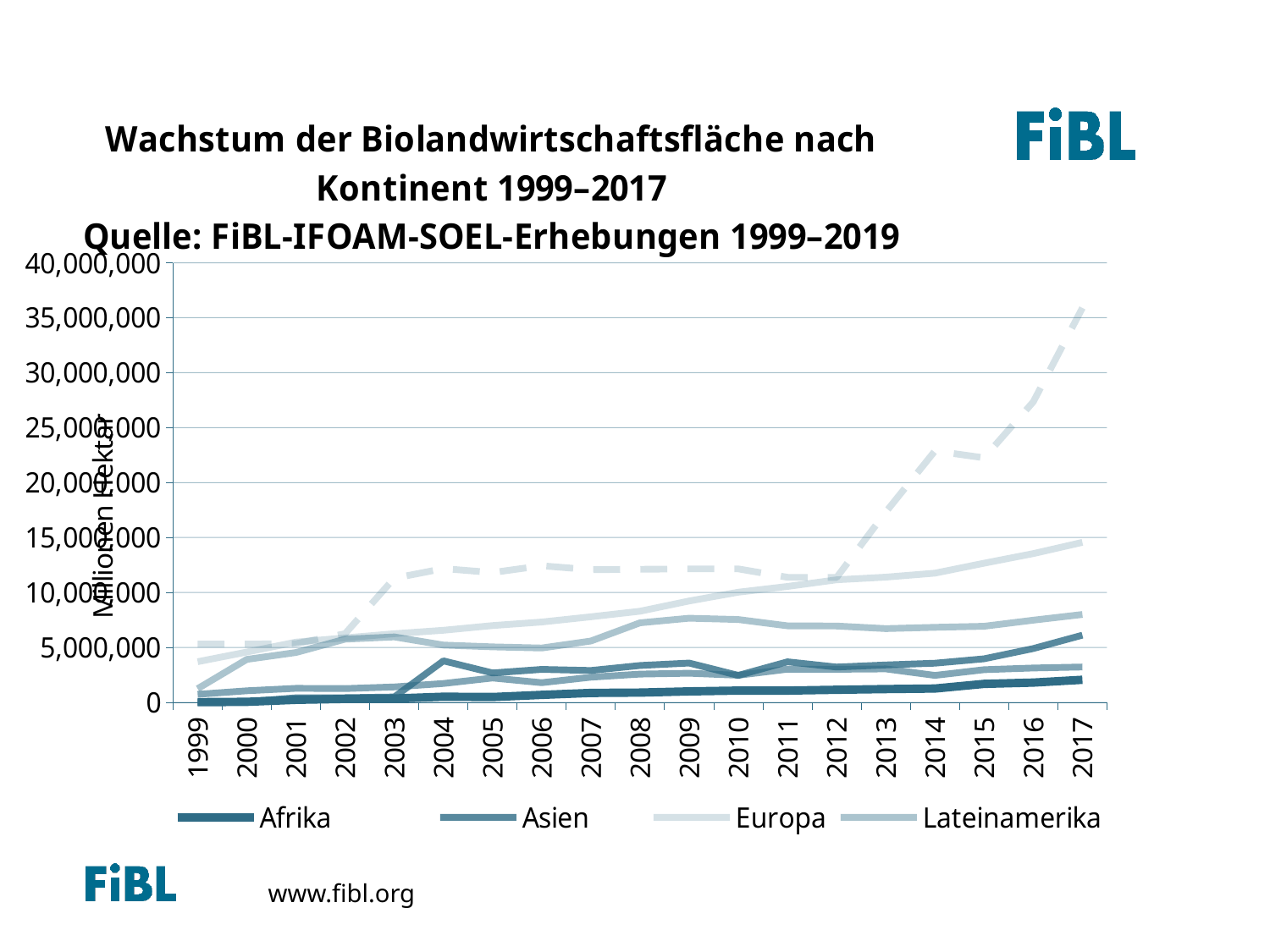
Is the value for Lateinamerika in 2017 greater or less than 5,000,000? greater Which is larger in 2017, the value for Europa or the value for Afrika? Europa Of the series listed in the legend, which has the lowest value in 2017? Afrika Does the Europa line rise or fall from 1999 to 2017? rise Is the value for Afrika in 2017 greater or less than 5,000,000? less What is the label on the y axis? Millionen Hektar How many series does the legend list? 4 How many years are shown along the x axis? 19 Is the value for Europa in 1999 greater or less than 5,000,000? less What kind of chart is shown on the slide? line chart Of the series listed in the legend, which has the highest value in 2017? Europa